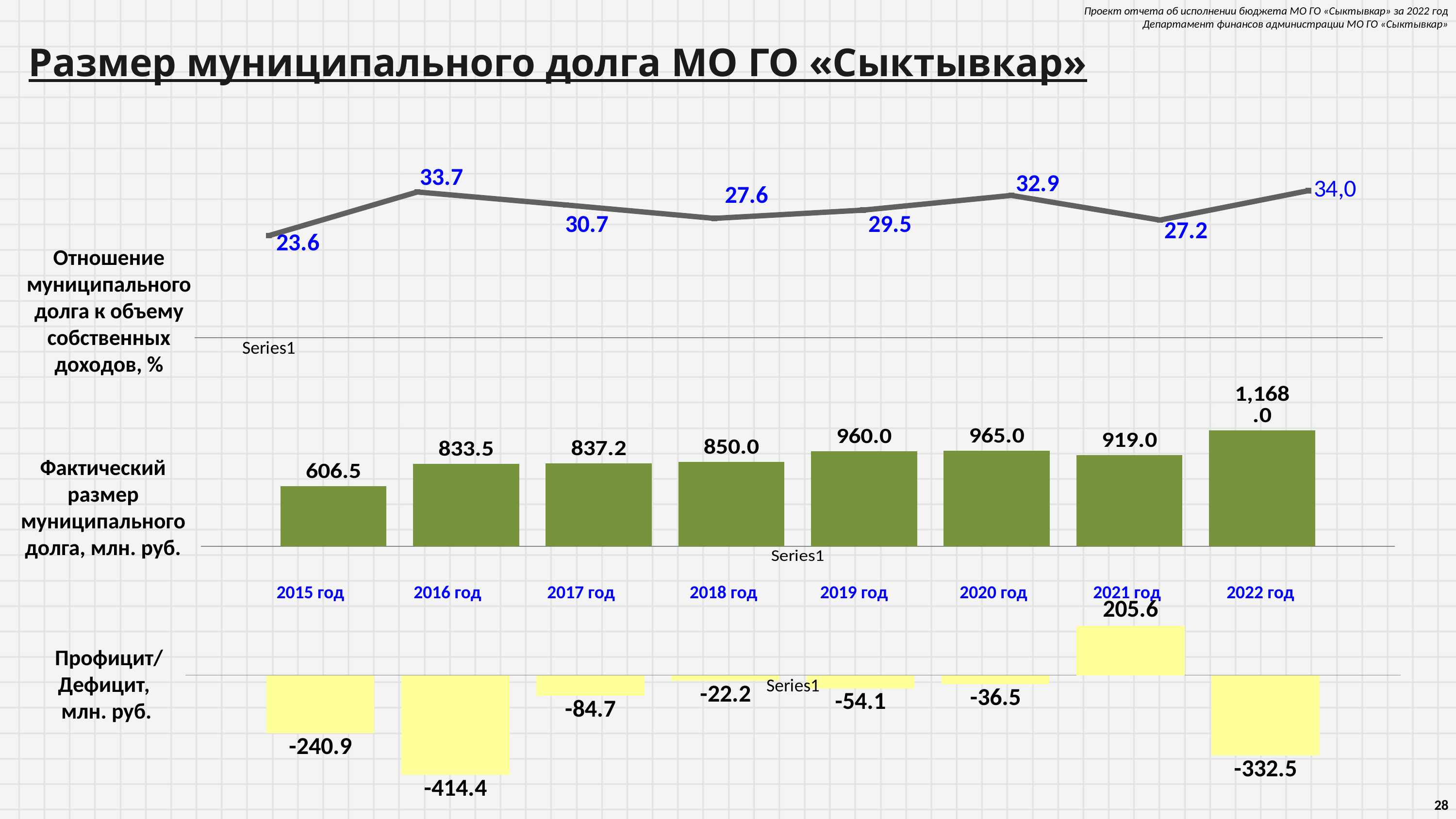
In the bottom chart (Профицит/Дефицит, млн. руб.), what is the value for 2016 год? -414.4 In the middle chart (Фактический размер муниципального долга, млн. руб.), what is the value for 2022 год? 1,168.0 In the middle chart (Фактический размер муниципального долга, млн. руб.), which year has the lowest value? 2015 год In the bottom chart (Профицит/Дефицит, млн. руб.), what is the value for 2018 год? -22.2 What kind of chart is the top chart (Отношение муниципального долга к объему собственных доходов, %)? Line chart In the middle chart (Фактический размер муниципального долга, млн. руб.), what is the value for 2015 год? 606.5 In the top chart (Отношение муниципального долга к объему собственных доходов, %), what is the value for 2016 год? 33.7 In the top chart (Отношение муниципального долга к объему собственных доходов, %), is the value for 2020 год or 2021 год larger? 2020 год In the top chart (Отношение муниципального долга к объему собственных доходов, %), which year has the lowest value? 2015 год In the bottom chart (Профицит/Дефицит, млн. руб.), which year is the only one with a positive value? 2021 год How many years are shown on the x axis of the middle chart (Фактический размер муниципального долга, млн. руб.)? 8 In the middle chart (Фактический размер муниципального долга, млн. руб.), what is the difference between the values for 2019 год and 2018 год? 110.0